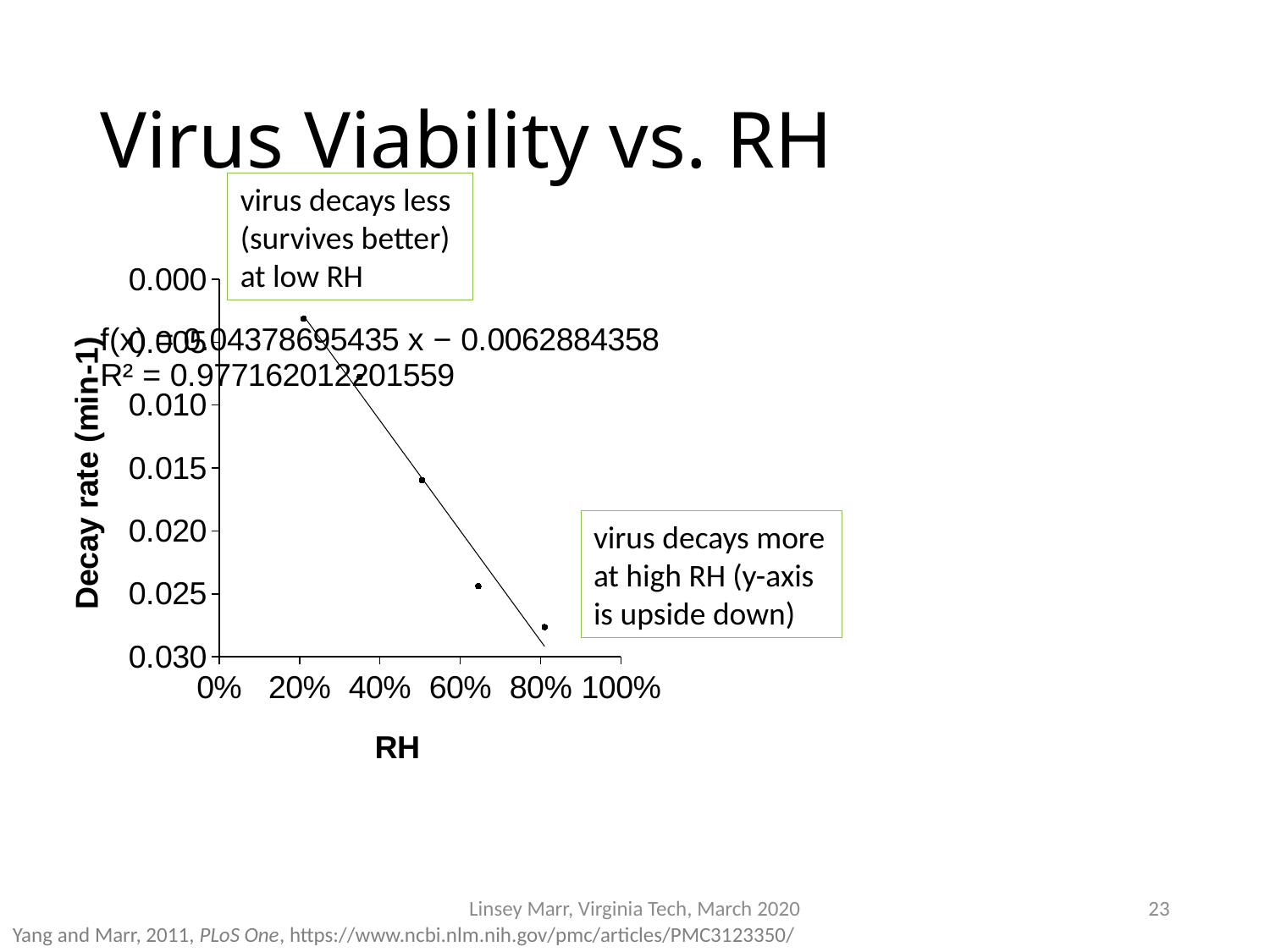
Which data point has the highest decay rate: the one at about 20% RH or the one at about 80% RH? the one at about 80% RH Is the decay rate for the data point at about 50% RH greater or less than 0.010? greater What kind of chart is shown on the slide? scatter chart What is the label of the y-axis? Decay rate (min-1) What is the title of the chart on the slide? Virus Viability vs. RH Does the decay rate increase or decrease as RH increases? increase What R² value is shown for the trendline? 0.977162012201559 Is the decay rate for the data point at about 20% RH greater or less than 0.005? less Is the decay rate for the data point at about 80% RH greater or less than 0.025? greater What is the trendline equation shown on the chart? f(x) = 0.04378695435 x − 0.0062884358 How many data points are plotted on the chart? 5